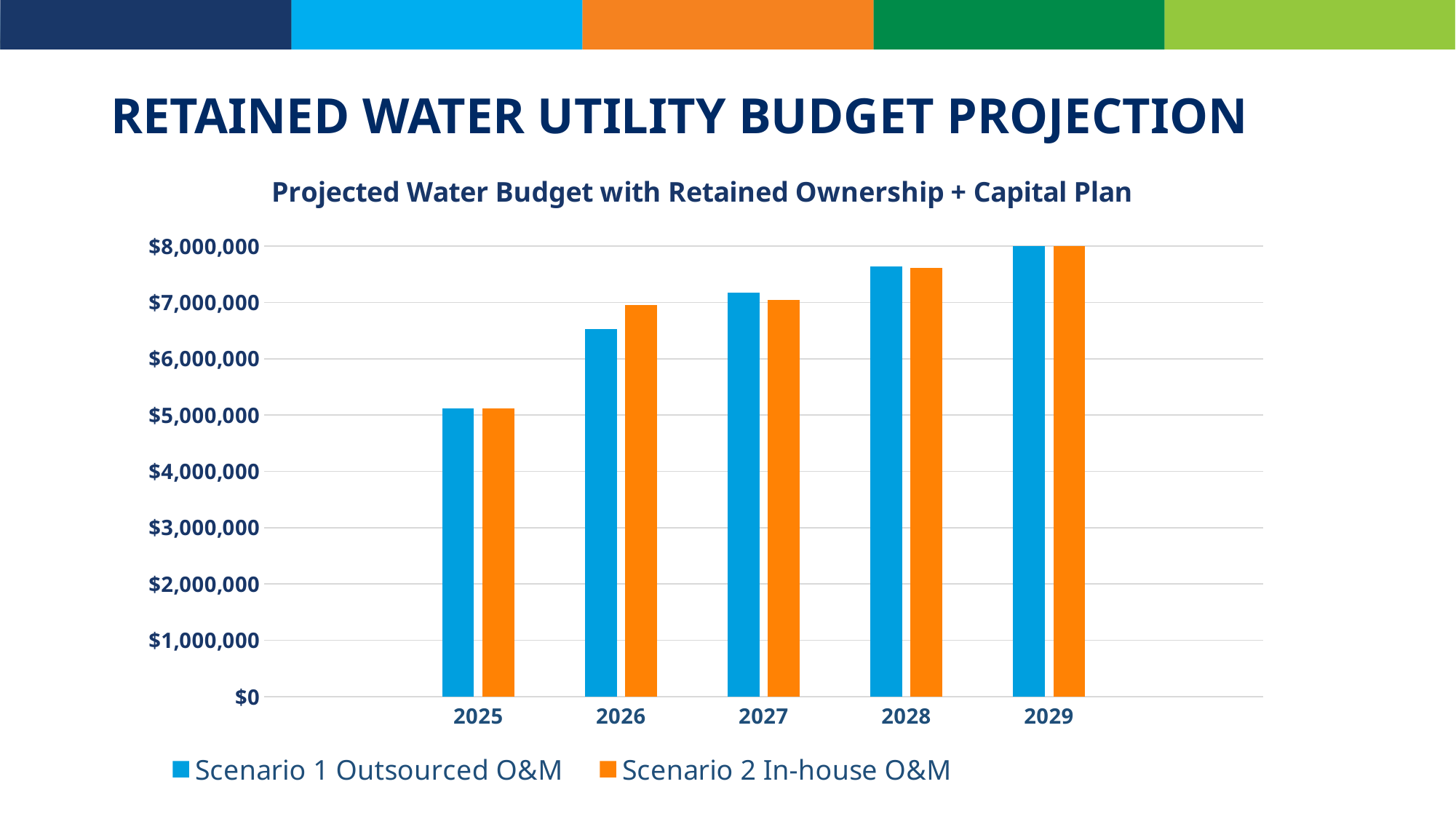
How many series does the legend list? 2 Which year has the highest value for Scenario 1 Outsourced O&M? 2029 Is the value for Scenario 2 In-house O&M in 2028 greater or less than $7,000,000? greater Is the value for Scenario 1 Outsourced O&M in 2026 greater or less than $6,000,000? greater What is the title of the chart? Projected Water Budget with Retained Ownership + Capital Plan Which year has the lowest value for Scenario 2 In-house O&M? 2025 Which colour represents Scenario 2 In-house O&M in the legend? orange Do the Scenario 1 Outsourced O&M values rise or fall from 2025 to 2029? rise Is the value for Scenario 1 Outsourced O&M in 2025 greater or less than $6,000,000? less In 2026, which is larger: Scenario 1 Outsourced O&M or Scenario 2 In-house O&M? Scenario 2 In-house O&M How many years are shown on the x axis? 5 What kind of chart is shown on the slide? bar chart